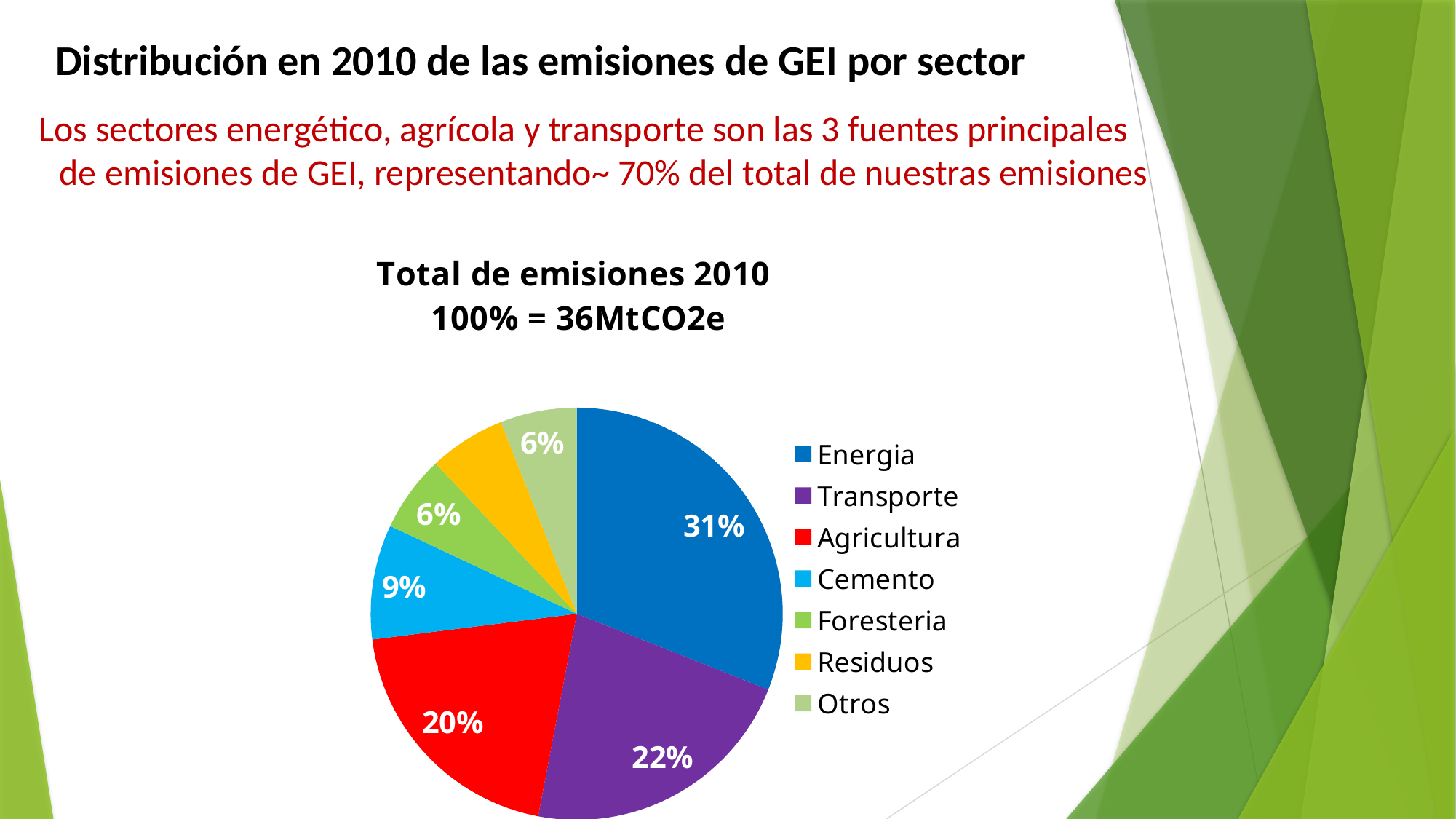
What is the title of the pie chart? Total de emisiones 2010 100% = 36MtCO2e How many sectors are listed in the legend of the pie chart? 7 Which slice is larger, Agricultura or Cemento? Agricultura What kind of chart is shown on the slide? Pie chart How many percentage points larger is the Energia slice than the Transporte slice? 9 percentage points What percentage is shown for Cemento? 9% What percentage is shown for Foresteria? 6% What share of emissions does the Energia slice represent? 31% What percentage is shown for Agricultura? 20% What percentage is shown for Transporte? 22% Which sector has the largest slice of the pie? Energia What is the combined share of Energia, Transporte and Agricultura? 73%